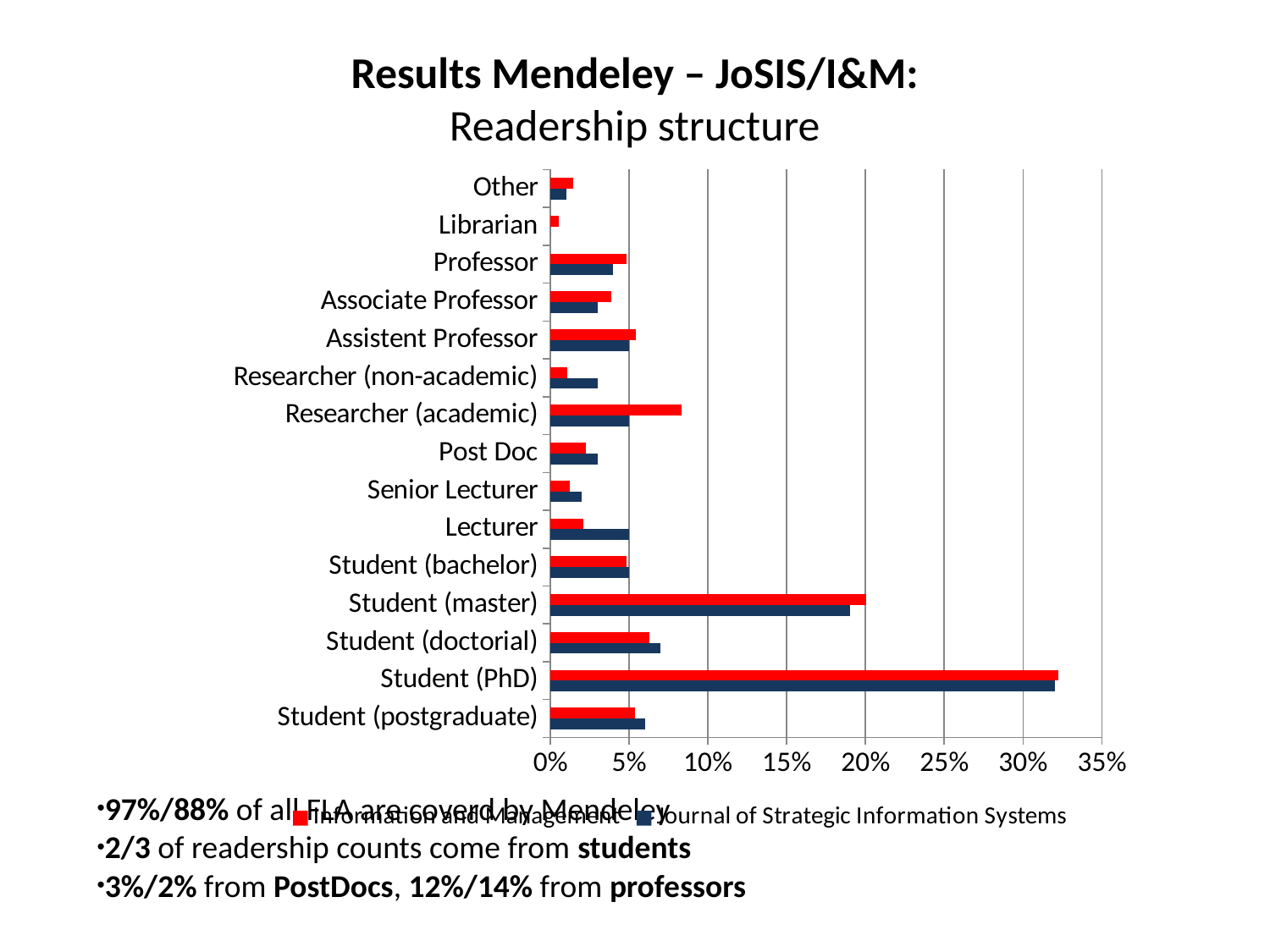
Which colour represents the Information and Management series? red What kind of chart is shown on the slide? bar chart For Lecturer, which series has the larger value: Information and Management or Journal of Strategic Information Systems? Journal of Strategic Information Systems How many series does the legend list? 2 For Researcher (academic), which series has the larger value: Information and Management or Journal of Strategic Information Systems? Information and Management Which category has the lowest value for Information and Management? Librarian How many categories are plotted on the chart? 15 Which category has the highest value for Information and Management? Student (PhD) Is the Information and Management value for Researcher (non-academic) greater or less than 5%? less Which category has the highest value for Journal of Strategic Information Systems? Student (PhD) Is the Information and Management value for Student (master) greater or less than 15%? greater Is the Information and Management value for Student (PhD) greater or less than 30%? greater